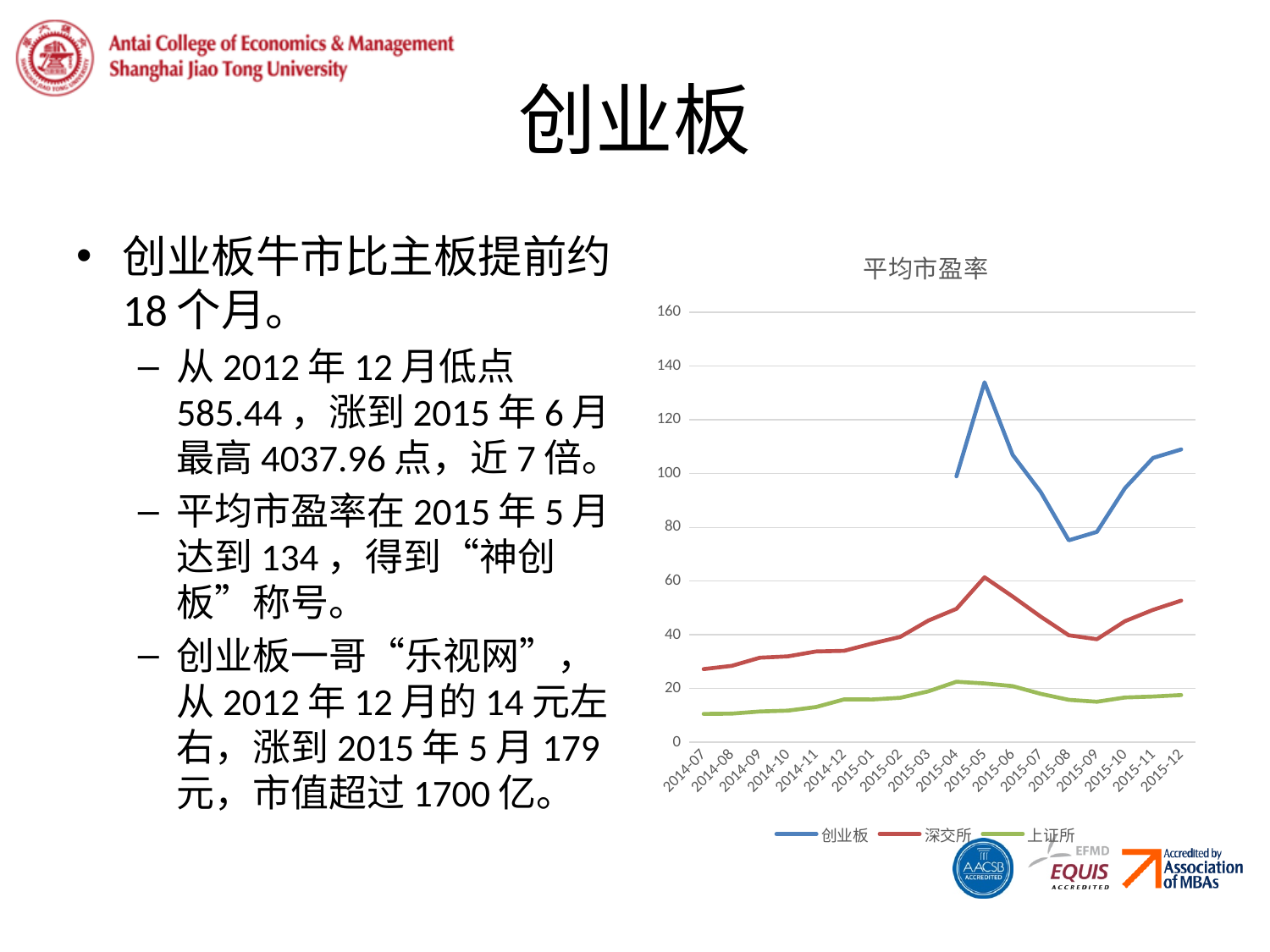
In which month does the 创业板 series reach its highest value? 2015-05 Is the value for 深交所 in 2014-07 greater or less than 40? less Does the 深交所 series rise or fall from 2014-07 to 2015-05? rise Is the value for 创业板 in 2015-05 greater or less than 120? greater Which series has the higher value in 2015-05, 深交所 or 上证所? 深交所 Which series has the highest value in 2015-12? 创业板 What is the title of the chart? 平均市盈率 Is the value for 上证所 in 2015-12 greater or less than 20? less How many months are shown along the x axis of the chart? 18 What kind of chart is shown on the slide? line chart How many series does the chart legend list? 3 In which month does the 深交所 series reach its highest value? 2015-05